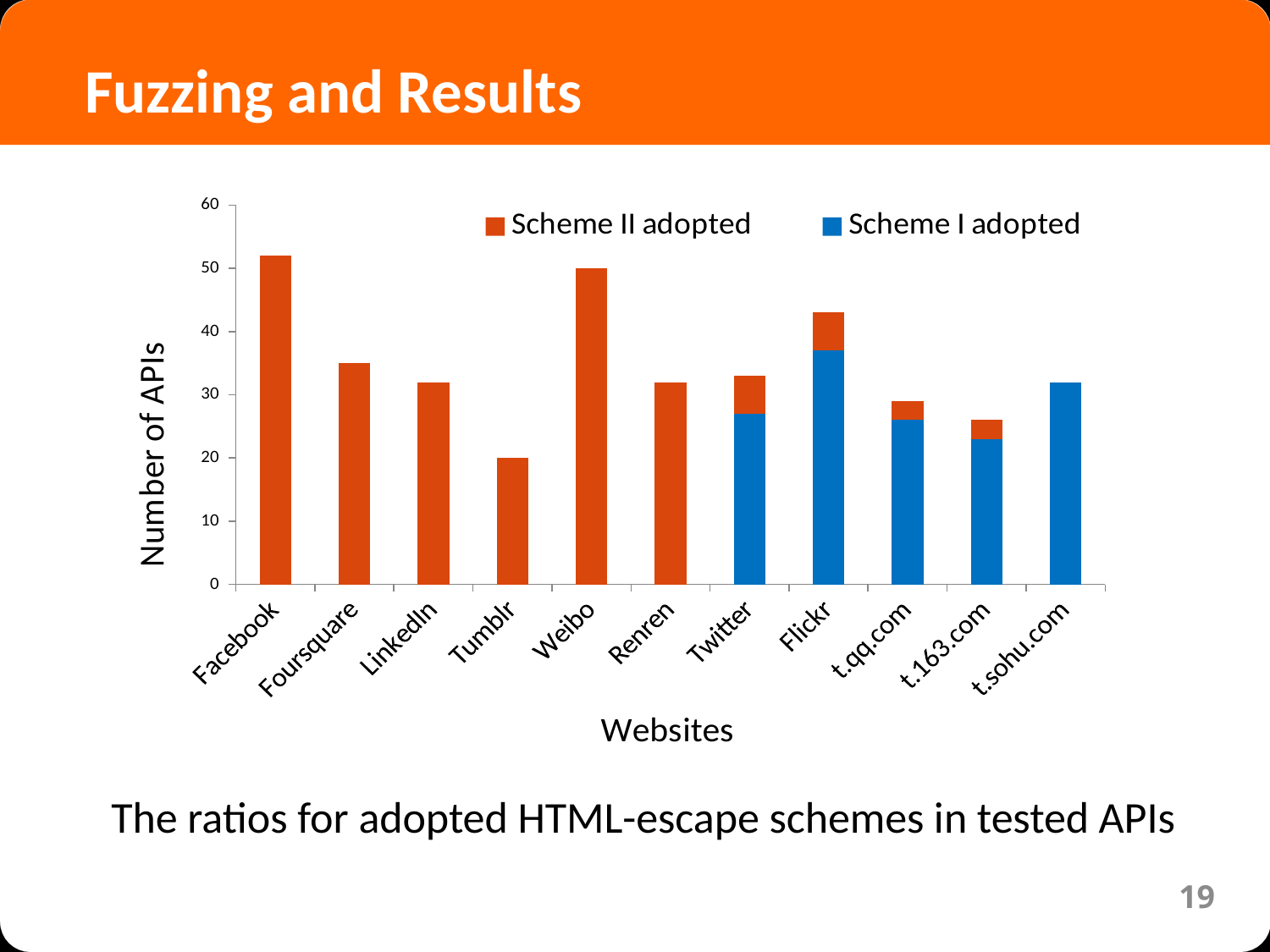
Is the value for t.163.com greater or less than 30? less How many websites are shown on the x axis of the chart? 11 What is the number of APIs for Weibo? 50 How many series does the chart legend list? 2 What is the title of the y axis? Number of APIs What kind of chart is shown on the slide? bar chart Which has more APIs, Flickr or Twitter? Flickr Which website has the lowest number of APIs? Tumblr Which series is shown in blue according to the legend? Scheme I adopted Is the total value for Flickr greater or less than 40? greater Is the value for Facebook greater or less than 50? greater What is the number of APIs for Tumblr? 20